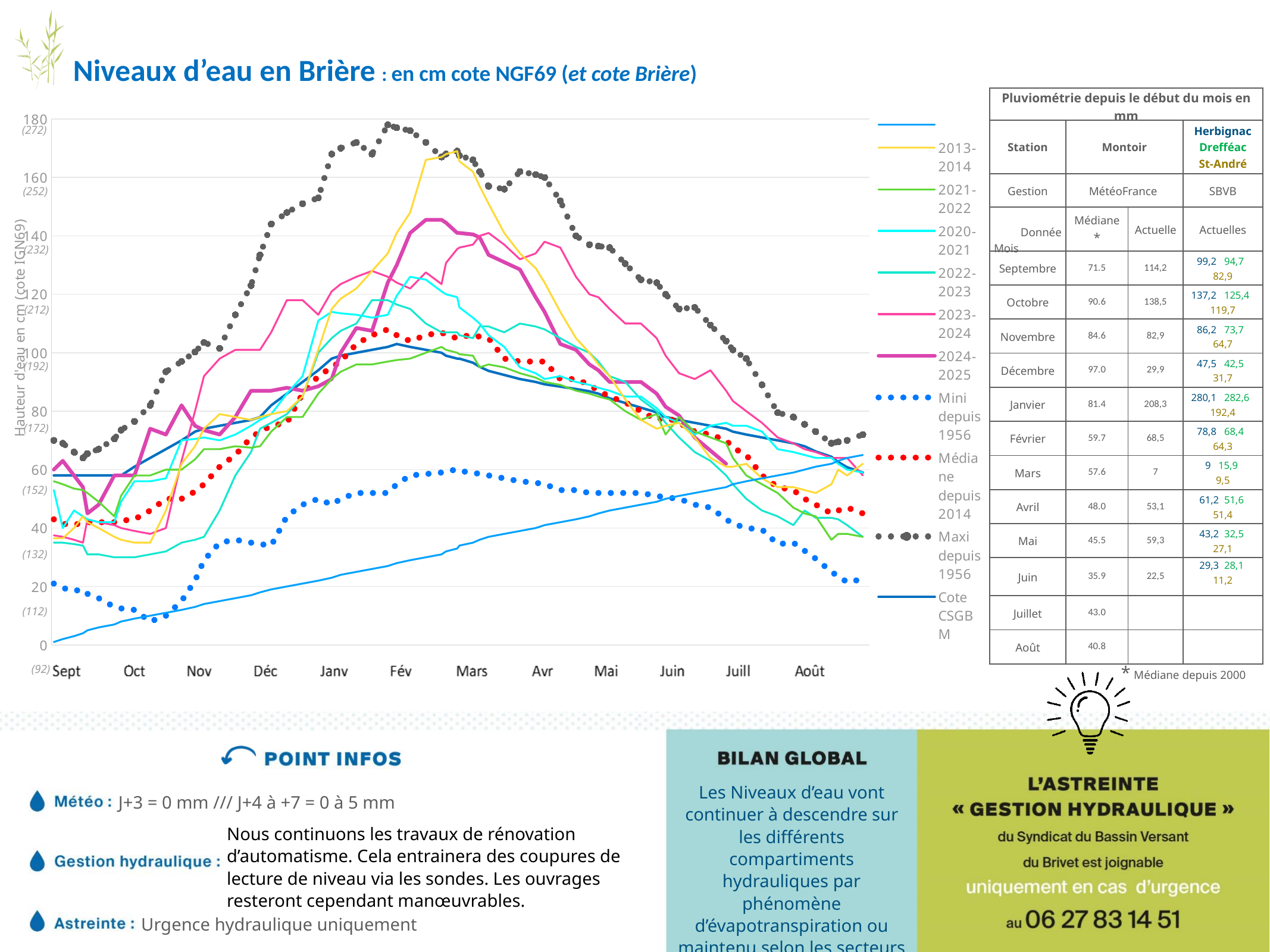
In Mars, which series has the higher value: '2013-2014' or '2021-2022'? 2013-2014 What kind of chart is shown on the slide? line chart Is the value of the 'Mini depuis 1956' series in Sept greater or less than 40? less How many labelled entries does the chart legend list? 10 Is the peak value of the '2024-2025' series greater or less than 120? greater In which month does the 'Maxi depuis 1956' series reach its peak? Fév Does the '2024-2025' series rise or fall from Fév to Juill? fall Does the 'Maxi depuis 1956' series rise or fall from Sept to Fév? rise How many months are labelled along the x axis of the chart? 12 What is the label of the chart's y axis? Hauteur d'eau en cm (cote IGN69) Which series reaches the highest value on the chart? Maxi depuis 1956 Is the peak value of the 'Maxi depuis 1956' series greater or less than 160? greater